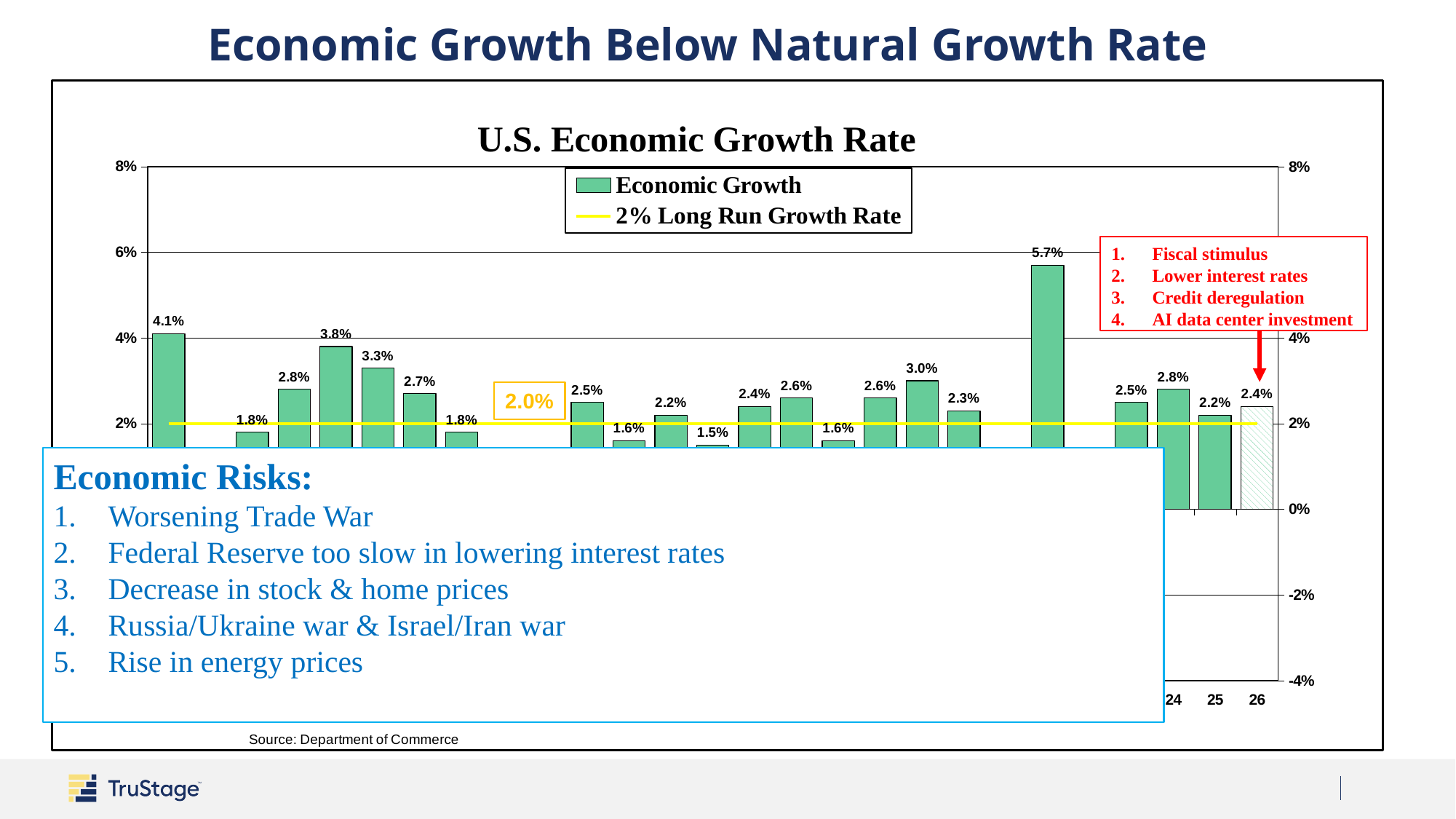
What is the difference between the economic growth rates for 24 and 25? 0.6% What is the economic growth rate shown for 26 in the U.S. Economic Growth Rate chart? 2.4% What type of chart is used to show the U.S. Economic Growth Rate? Bar and line chart Is the economic growth rate for 26 greater or less than 2%? greater What is the title of the chart on the slide? U.S. Economic Growth Rate What is the highest economic growth rate labeled on the U.S. Economic Growth Rate chart? 5.7% What is the economic growth rate shown for 25 in the U.S. Economic Growth Rate chart? 2.2% What value does the yellow horizontal line in the chart represent? 2.0% Which year has the larger economic growth rate, 25 or 26? 26 What is the economic growth rate shown for 24 in the U.S. Economic Growth Rate chart? 2.8% What is the difference between the economic growth rates for 26 and 25? 0.2% How many series does the legend of the U.S. Economic Growth Rate chart list? 2